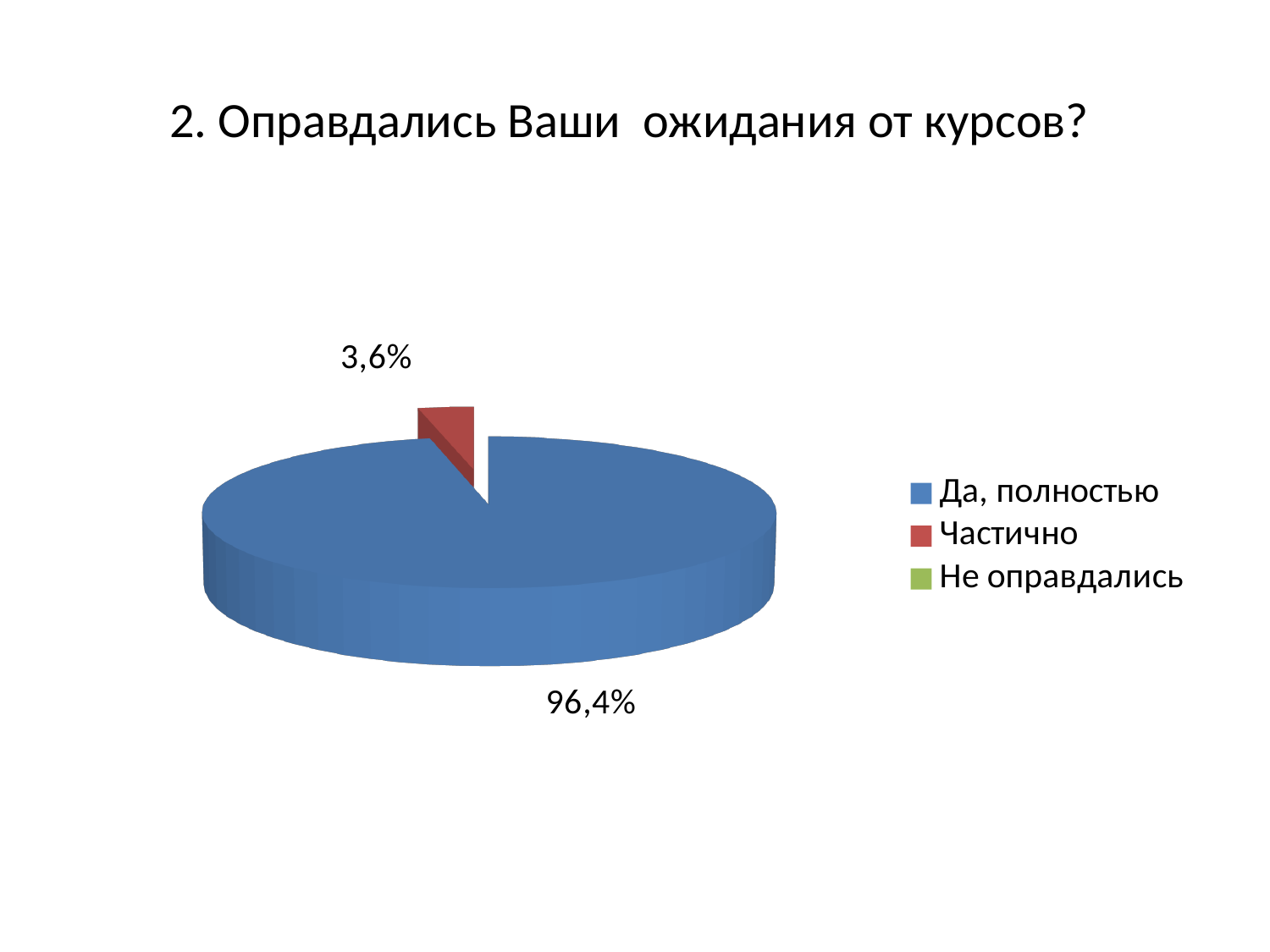
What is the difference in percentage points between "Да, полностью" and "Частично"? 92,8 What share of the pie does "Да, полностью" represent? 96,4% Is the share for "Да, полностью" greater or less than 90%? greater Which category has the largest slice of the pie? Да, полностью What kind of chart is shown on the slide? Pie chart How many entries does the legend list? 3 Is the share for "Частично" greater or less than 10%? less What colour is the slice for "Частично"? Red What is the title of the chart? 2. Оправдались Ваши ожидания от курсов? Which of the two labelled slices is larger, "Да, полностью" or "Частично"? Да, полностью What share of the pie does "Частично" represent? 3,6%